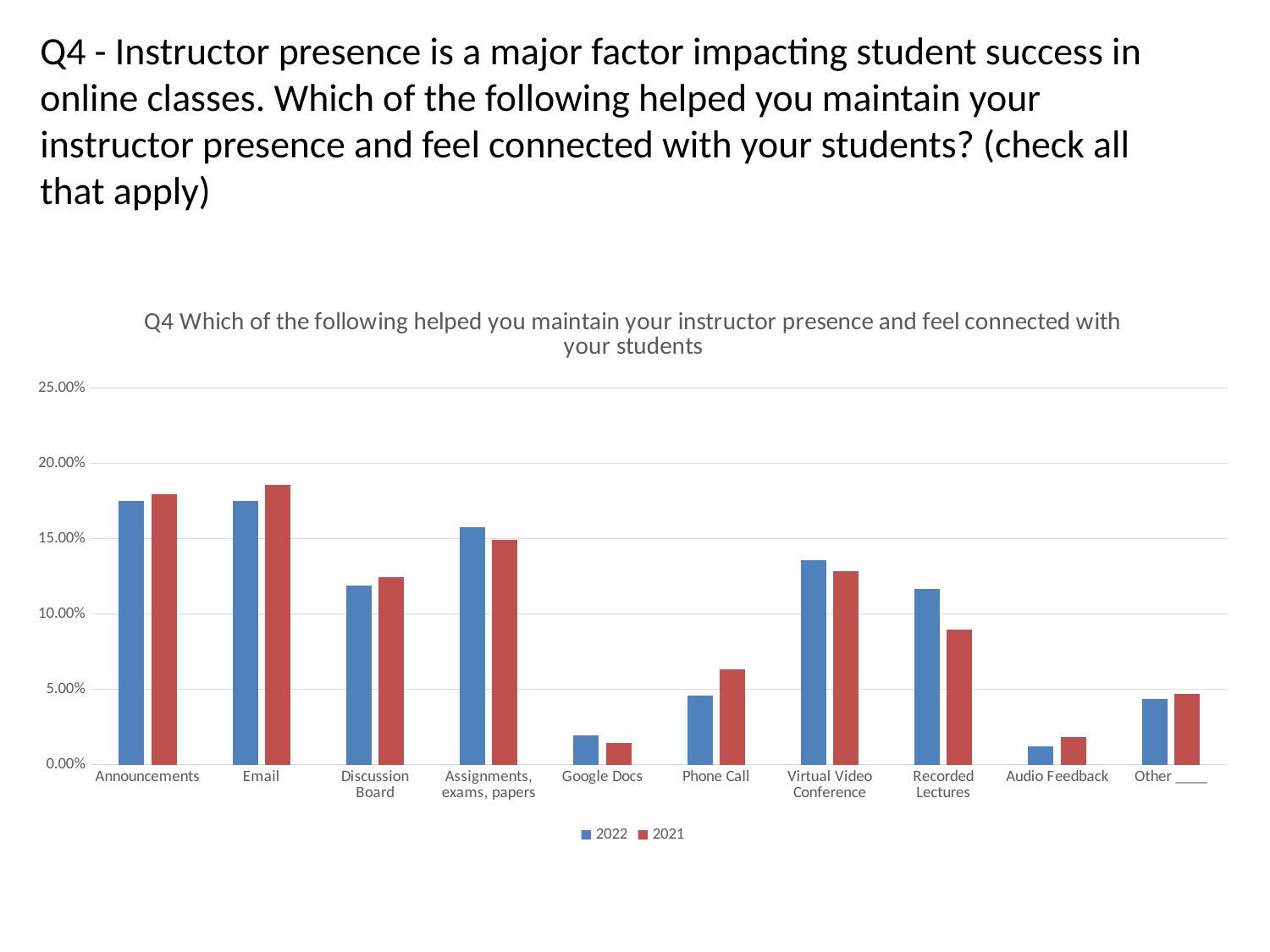
What kind of chart is shown on the slide? bar chart For Phone Call, which series has the larger value, 2022 or 2021? 2021 Is the 2021 value for Recorded Lectures greater or less than 10.00%? less Which series does the legend list first? 2022 Is the 2022 value for Virtual Video Conference greater or less than 10.00%? greater For Recorded Lectures, which series has the larger value, 2022 or 2021? 2022 How many categories are shown on the x axis? 10 Is the 2021 value for Google Docs greater or less than 5.00%? less Which category has the lowest 2022 value? Audio Feedback How many series does the legend list? 2 Which category has the lowest 2021 value? Google Docs